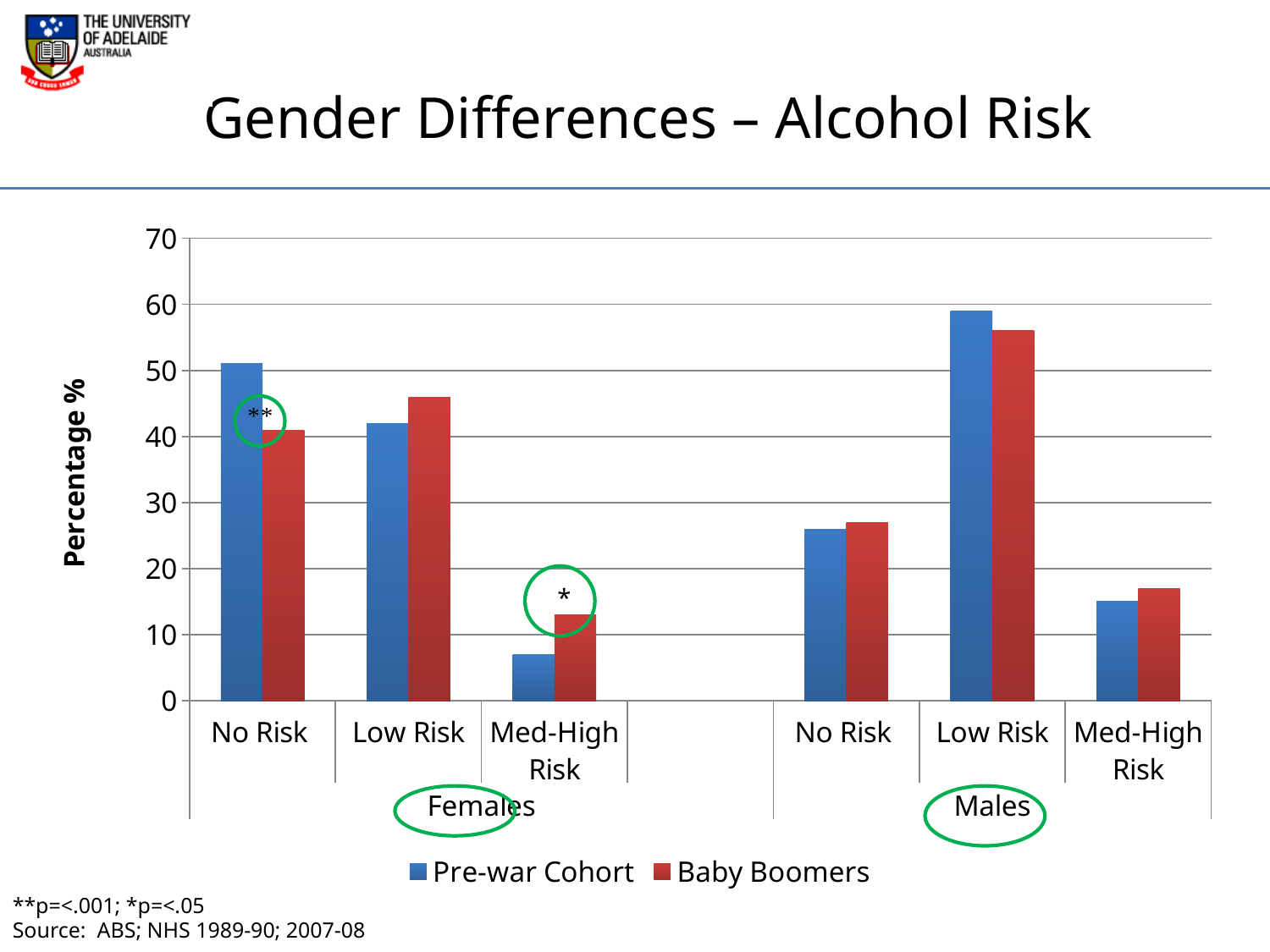
For Females Med-High Risk, which series has the larger value, Pre-war Cohort or Baby Boomers? Baby Boomers Is the Pre-war Cohort value for Females Med-High Risk greater or less than 10? less What is the label on the y axis of the chart? Percentage % For the Pre-war Cohort, which category has the lowest bar? Females Med-High Risk How many series does the legend list? 2 For Females No Risk, which series has the larger value, Pre-war Cohort or Baby Boomers? Pre-war Cohort For Baby Boomers, which category has the highest bar? Males Low Risk Is the Baby Boomers value for Males Med-High Risk greater or less than 20? less For the Pre-war Cohort, which category has the highest bar? Males Low Risk Is the Pre-war Cohort value for Males Low Risk greater or less than 50? greater What kind of chart is shown on the slide? Bar chart How many risk categories are plotted along the x axis in total? 6